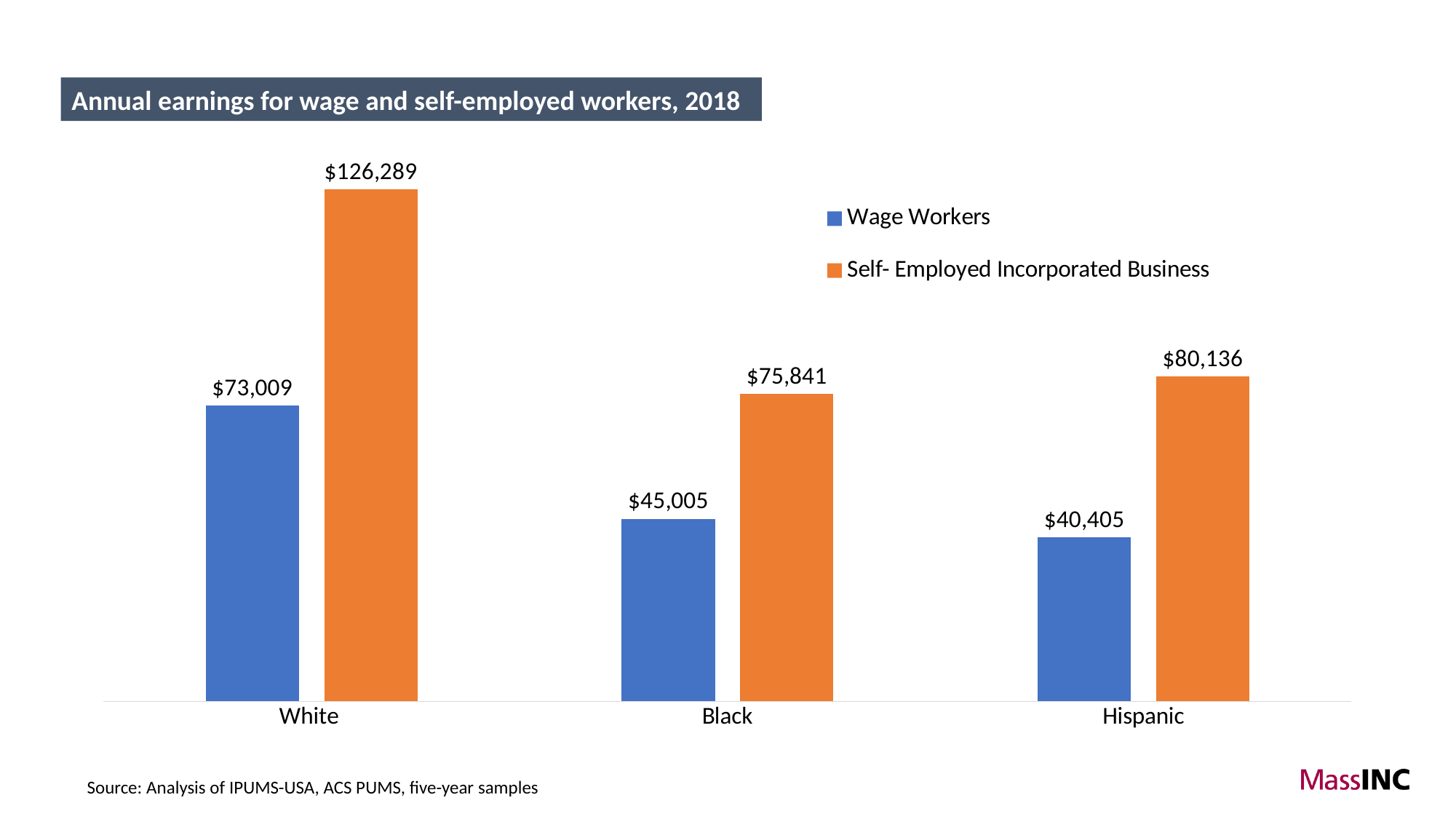
How many series does the legend list? 2 Which group has the highest annual earnings for self-employed incorporated business workers? White What are the annual earnings for Black self-employed incorporated business workers? $75,841 What are the annual earnings for White wage workers? $73,009 What are the annual earnings for Hispanic wage workers? $40,405 Which group has the lowest annual earnings for wage workers? Hispanic How many groups are shown on the x axis? 3 What is the difference between Black and Hispanic wage worker earnings? $4,600 What kind of chart is shown on the slide? Bar chart What is the difference between self-employed incorporated business earnings and wage worker earnings for White workers? $53,280 What is the title of the chart? Annual earnings for wage and self-employed workers, 2018 Which is larger: Hispanic self-employed incorporated business earnings or Black self-employed incorporated business earnings? Hispanic self-employed incorporated business earnings